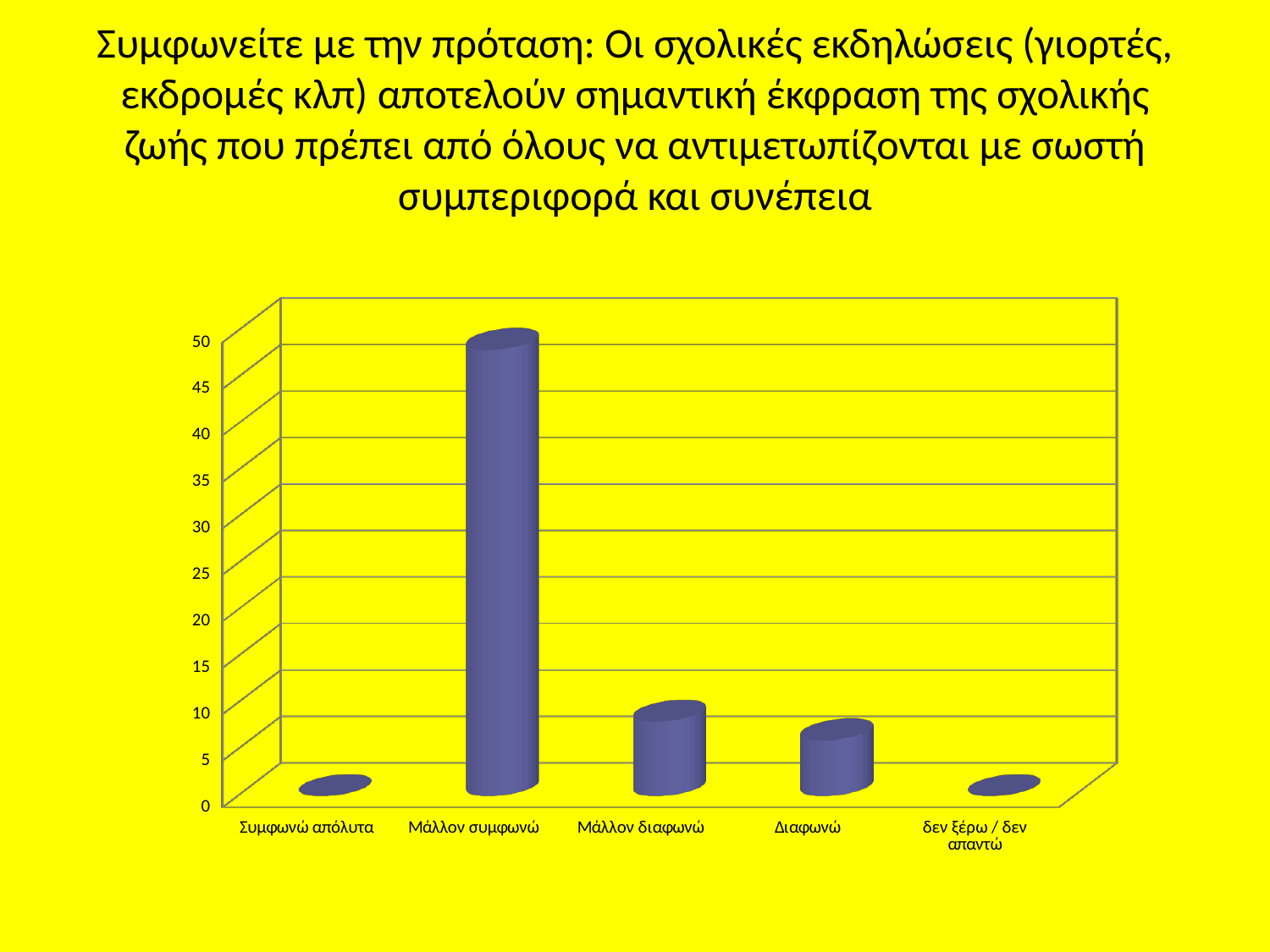
Which category has the highest value in the chart? Μάλλον συμφωνώ Is the value for Μάλλον διαφωνώ greater or less than 10? less Which is larger, the value for Διαφωνώ or the value for Συμφωνώ απόλυτα? Διαφωνώ What is the label of the last category on the x axis of the chart? δεν ξέρω / δεν απαντώ Which is larger, the value for Μάλλον συμφωνώ or the value for Μάλλον διαφωνώ? Μάλλον συμφωνώ Is the value for δεν ξέρω / δεν απαντώ greater or less than 5? less Is the value for Διαφωνώ greater or less than 10? less How many categories are shown on the x axis of the chart? 5 What is the highest value shown on the vertical axis of the chart? 50 What kind of chart is shown on the slide? bar chart